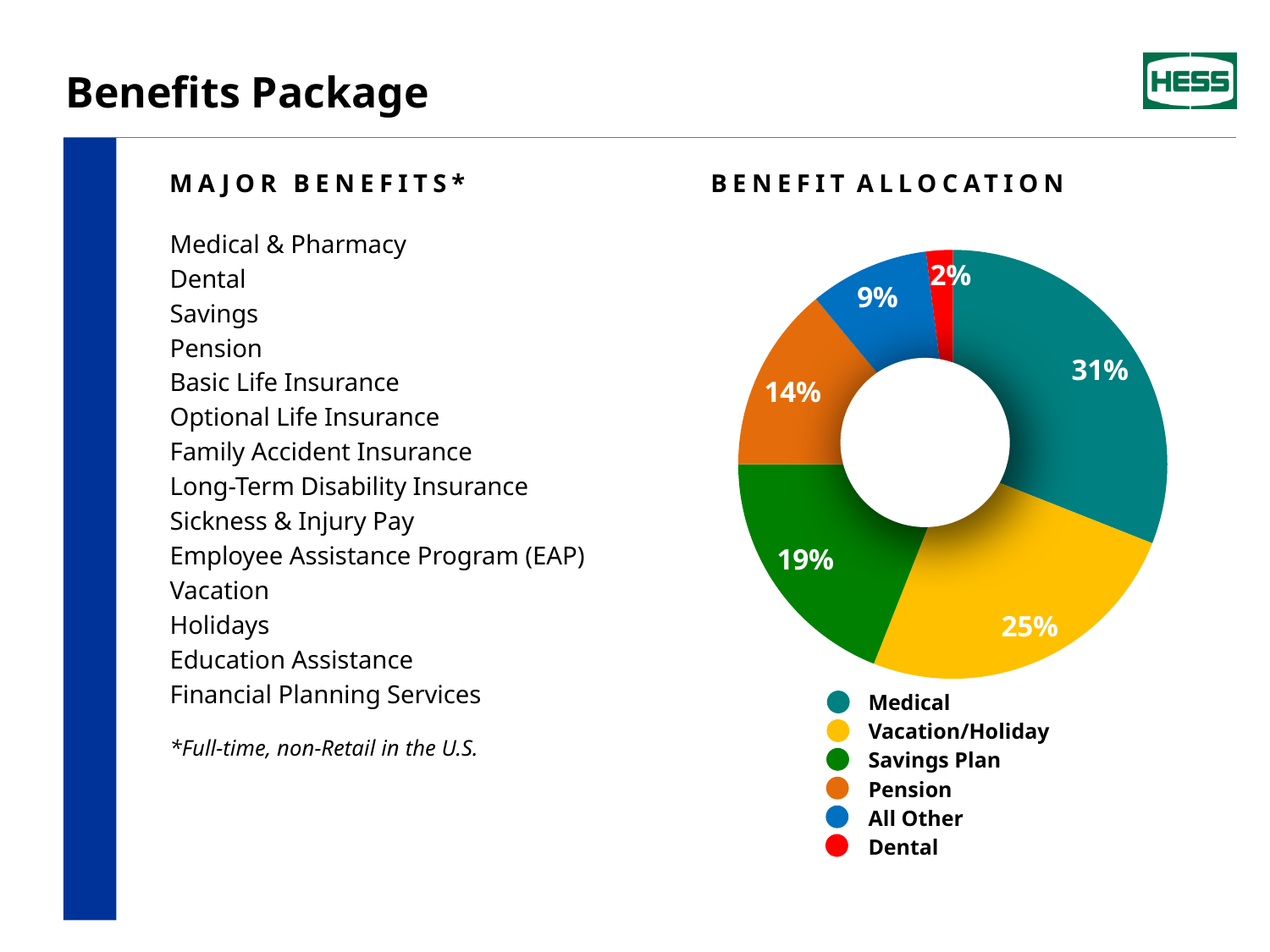
What share of the benefit allocation goes to Dental? 2% What colour represents Pension in the benefit allocation chart? Orange What share of the benefit allocation goes to Pension? 14% What share of the benefit allocation goes to Savings Plan? 19% How many categories does the benefit allocation chart show? 6 What share of the benefit allocation goes to Medical? 31% What is the difference in percentage points between the Medical and Pension shares? 17 Which category has the smallest share of the benefit allocation? Dental Which category has the largest share of the benefit allocation? Medical What share of the benefit allocation goes to Vacation/Holiday? 25% What kind of chart is used to show the benefit allocation? Doughnut (pie) chart Which has a larger share of the benefit allocation, Savings Plan or All Other? Savings Plan